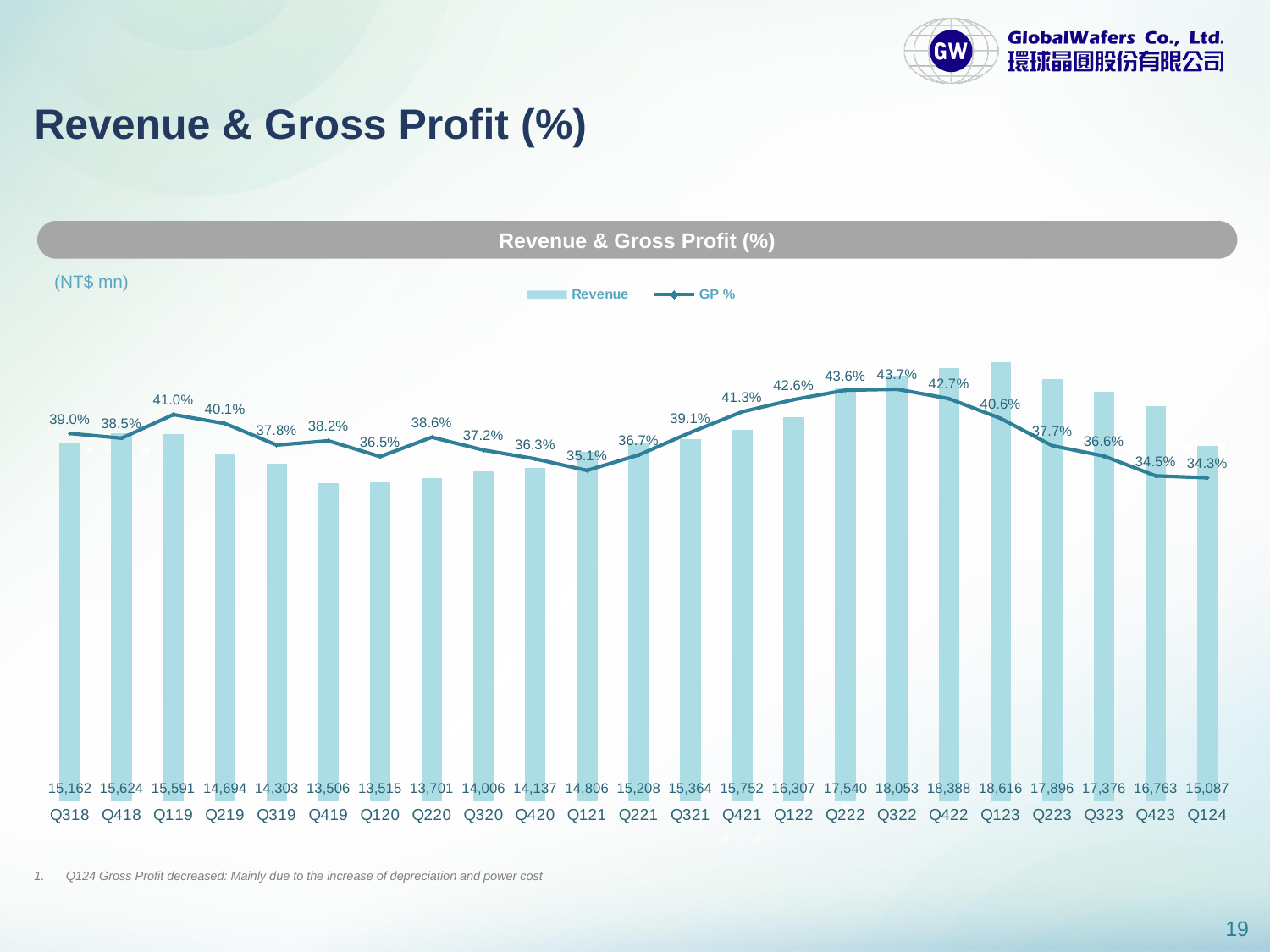
How many quarters are shown on the x axis? 23 What is the GP % for Q322? 43.7% Which quarter has the lowest GP %? Q124 What is the GP % for Q121? 35.1% What kind of chart is this? Combination bar and line chart Which quarter has the higher revenue, Q222 or Q223? Q223 What is the difference in revenue between Q123 and Q124? 3,529 Which quarter has the highest revenue? Q123 Which quarter has the lowest revenue? Q419 How many series does the legend list? 2 What is the revenue for Q123? 18,616 What is the revenue for Q124? 15,087